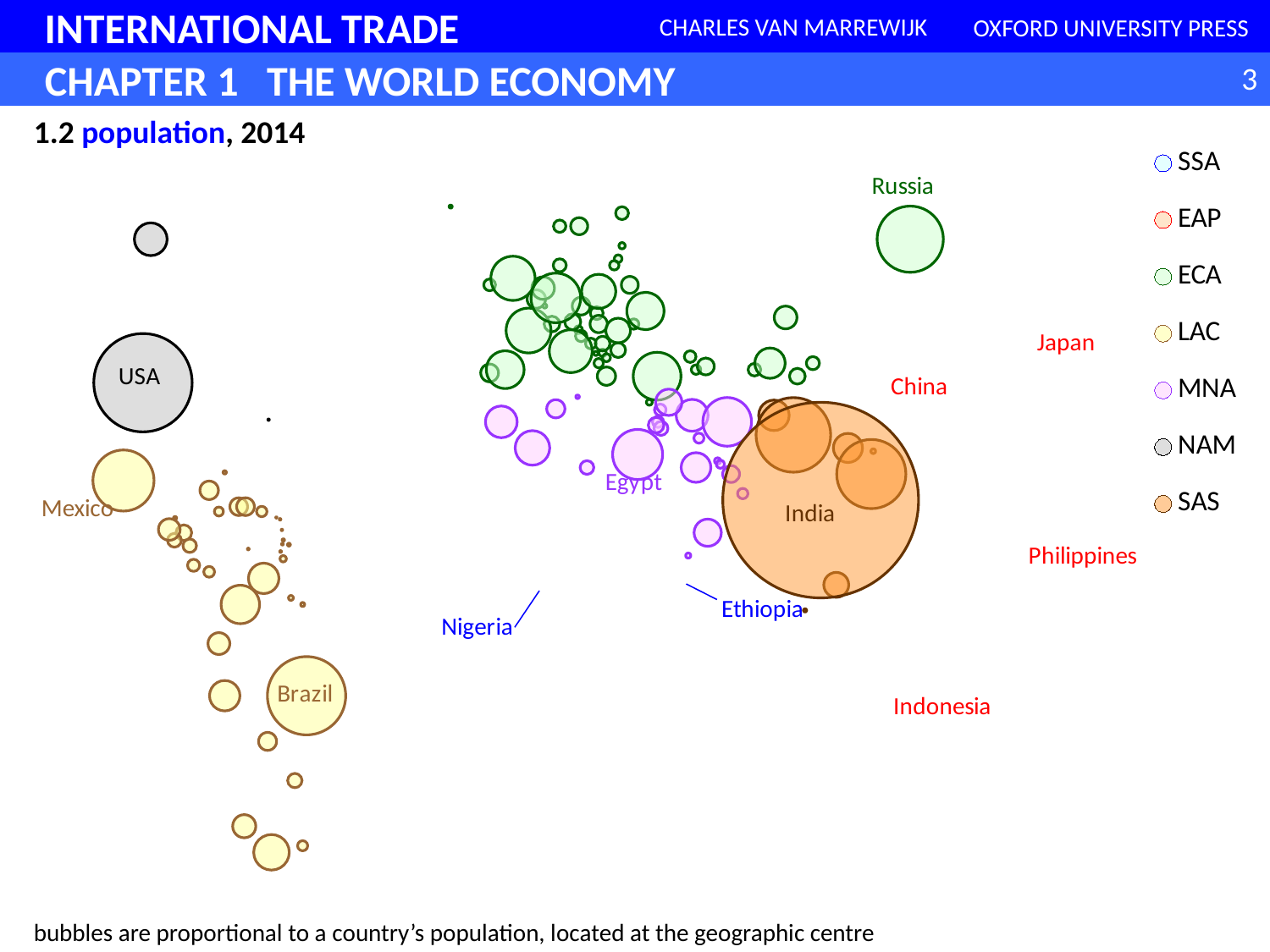
Which bubble is larger, Brazil or Mexico? Brazil Which legend region does the Russia bubble belong to, based on its green colour? ECA What is the title of the chart? 1.2 population, 2014 Which region in the legend is shown in orange? SAS Which legend region does the Egypt bubble belong to, based on its purple colour? MNA Which bubble is larger, Russia or Mexico? Russia According to the note below the chart, what are the bubbles proportional to? a country's population What kind of chart is shown on the slide? bubble chart Which labelled country has the largest bubble on the chart? India How many regions does the legend list? 7 Which bubble is larger, India or USA? India